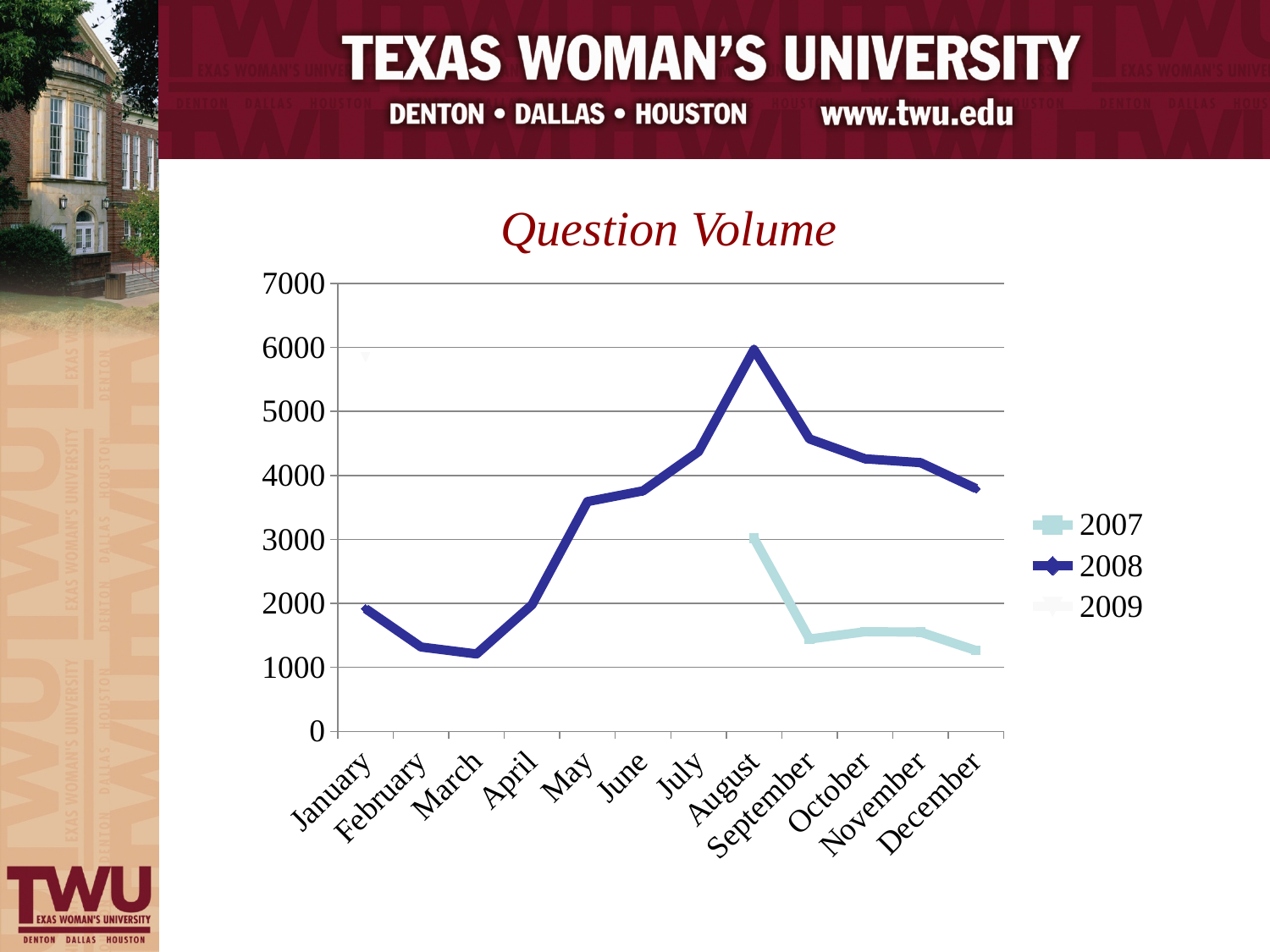
In September, which series has the larger value, 2007 or 2008? 2008 Is the value for 2008 in August greater or less than 5000? greater What kind of chart is shown on the slide? line chart Does the 2008 series rise or fall from March to August? rise Is the value for 2007 in December greater or less than 2000? less Is the value for 2008 in March greater or less than 2000? less In which month does the 2008 series reach its highest value? August How many series does the legend list? 3 In which month does the 2007 series reach its lowest value? December How many months are shown along the x axis? 12 What is the title of the chart? Question Volume